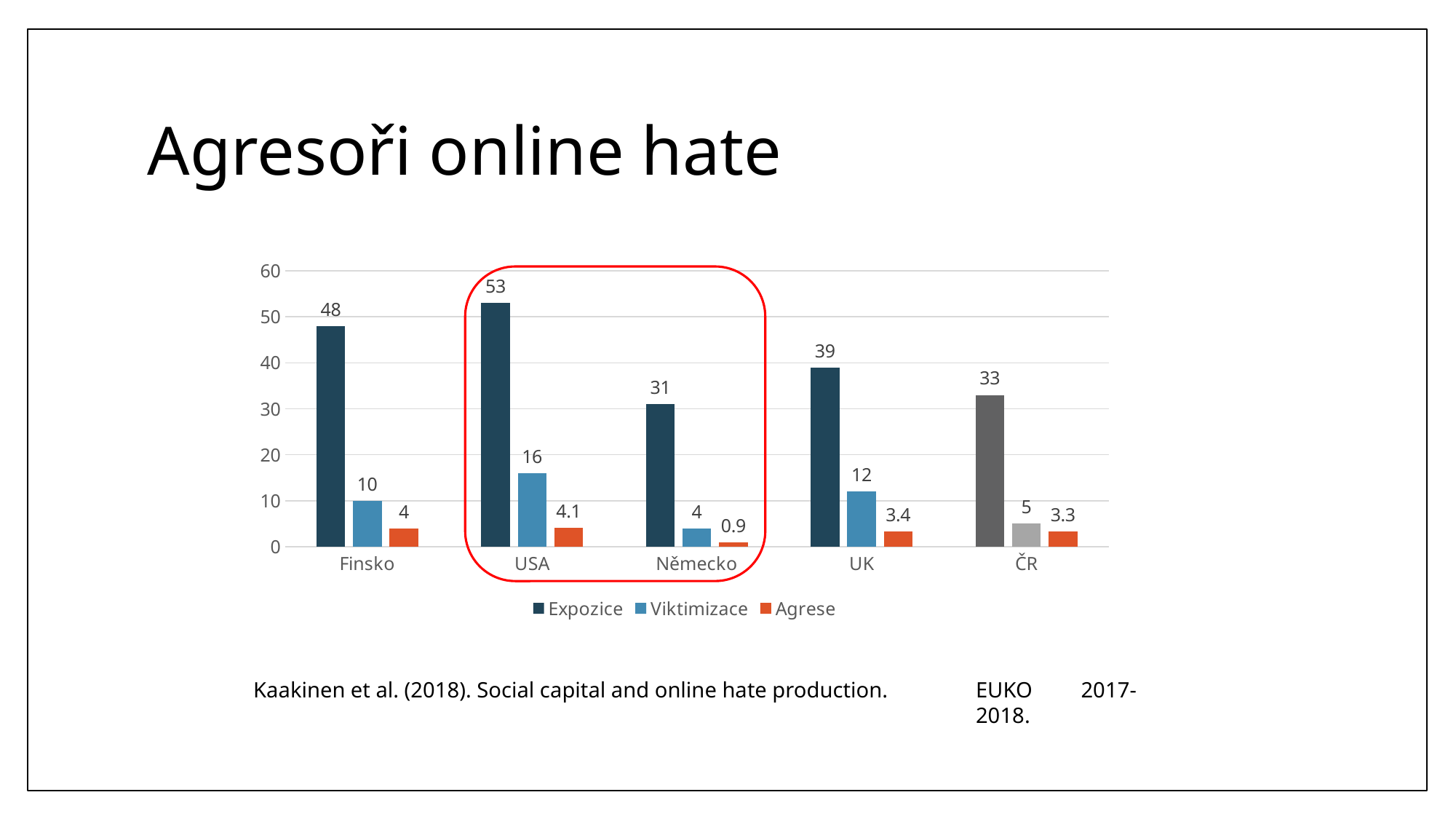
Which is larger, the Viktimizace value for Finsko or for UK? UK What kind of chart is shown on the slide? Bar chart What is the Agrese value for ČR? 3.3 What is the Agrese value for Německo? 0.9 What is the difference between the Expozice values for USA and Německo? 22 How many countries are shown on the x axis? 5 Which two countries are enclosed by the red outline on the chart? USA and Německo How many series does the legend list? 3 What is the Viktimizace value for UK? 12 Which country has the highest Expozice value? USA Which country has the lowest Agrese value? Německo What is the Expozice value for USA? 53